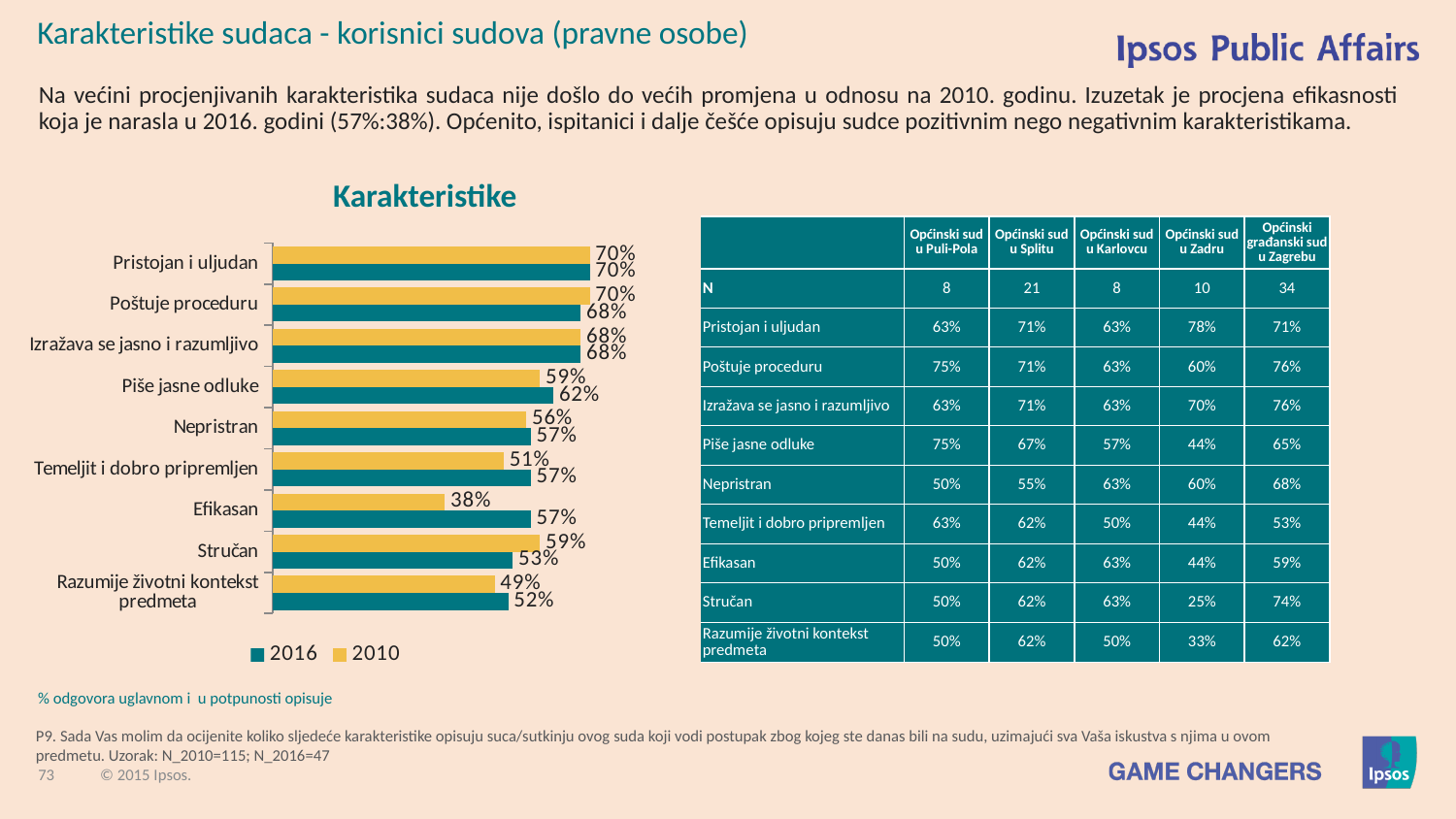
In the Karakteristike chart, which category has the lowest 2010 value? Efikasan In the Karakteristike chart, which colour represents the 2016 series? teal In the Karakteristike chart, what is the 2016 value for Efikasan? 57% In the Karakteristike chart, what is the 2010 value for Efikasan? 38% In the Karakteristike chart, is the 2010 value for Stručan larger or smaller than the 2016 value for Stručan? larger In the Karakteristike chart, what is the 2016 value for Stručan? 53% In the Karakteristike chart, what is the difference between the 2016 and 2010 values for Efikasan? 19% How many series does the legend of the Karakteristike chart list? 2 In the Karakteristike chart, what is the 2010 value for Razumije životni kontekst predmeta? 49% What kind of chart is shown on the slide? bar chart In the Karakteristike chart, which category has the lowest 2016 value? Razumije životni kontekst predmeta How many categories are plotted in the Karakteristike chart? 9